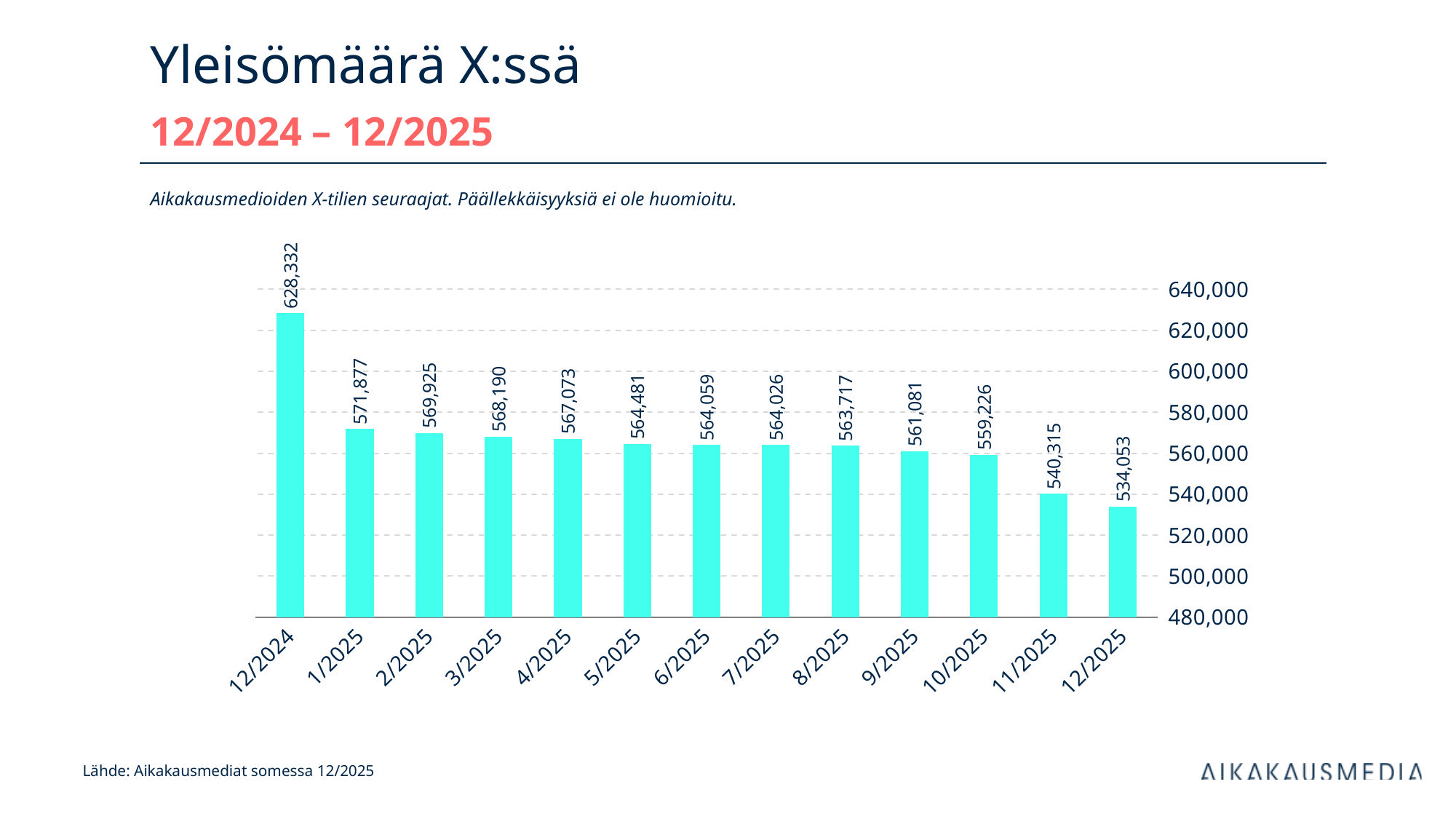
What type of chart is shown on the slide? Bar chart What is the difference between the values for 12/2024 and 12/2025? 94,279 Which is larger, the value for 10/2025 or the value for 11/2025? 10/2025 Is the value for 12/2024 greater or less than 620,000? greater Which month has the highest value? 12/2024 What is the value for 12/2025? 534,053 How many months (bars) are plotted in the chart? 13 Which month has the lowest value? 12/2025 What is the difference between the values for 11/2025 and 12/2025? 6,262 What is the value for 12/2024? 628,332 What is the value for 6/2025? 564,059 Do the values generally rise or fall from 12/2024 to 12/2025? Fall